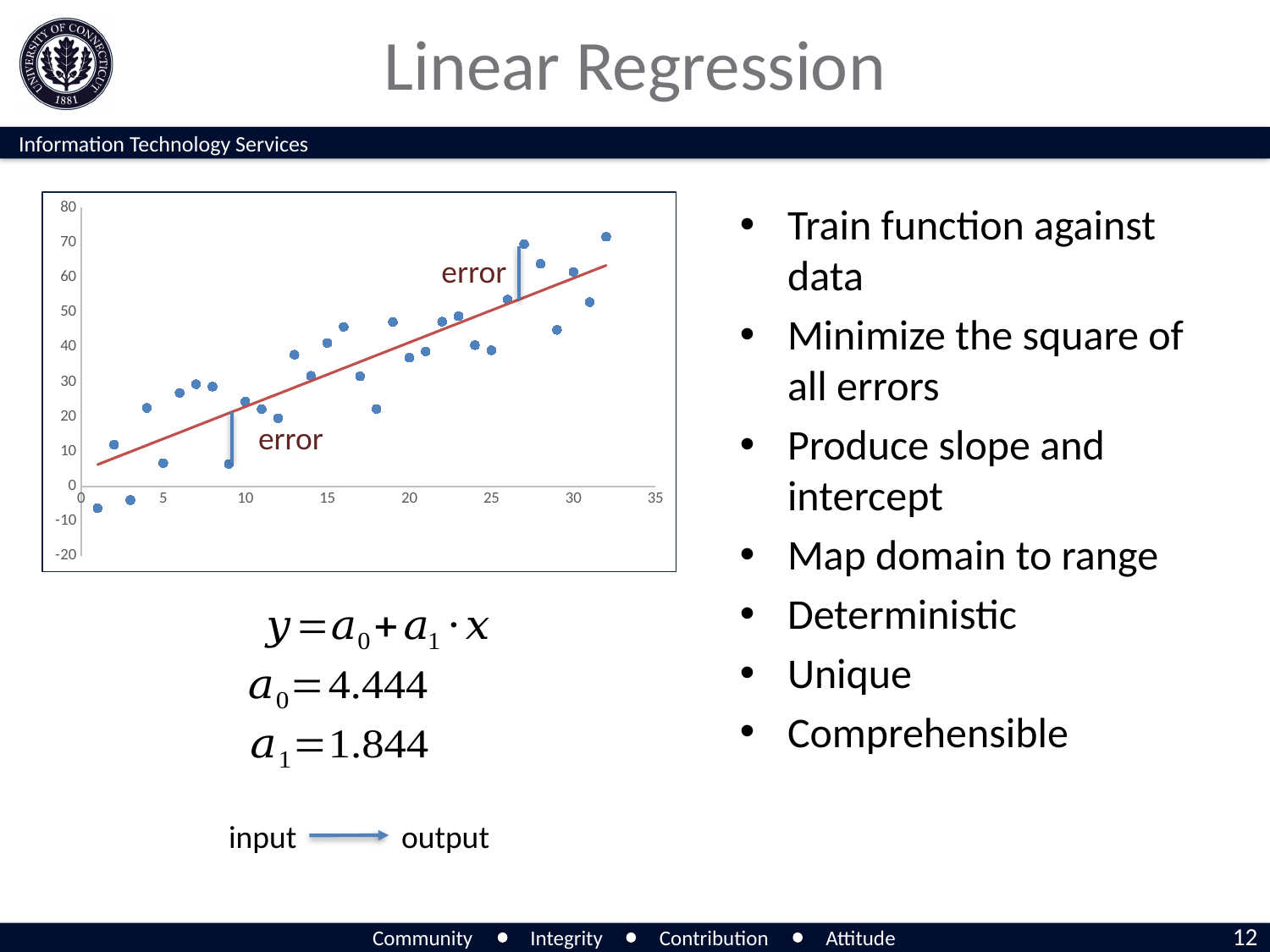
Is the value of the point plotted at x = 18 greater or less than 30? less What kind of chart is shown on the slide? scatter chart What word labels the vertical blue segments between the points and the fitted line? error Is the value of the point plotted at x = 5 greater or less than 10? less Is the value of the point plotted at x = 13 greater or less than 30? greater What is the highest value shown on the chart's y axis? 80 Do the plotted points generally rise or fall as x increases along the x axis? rise